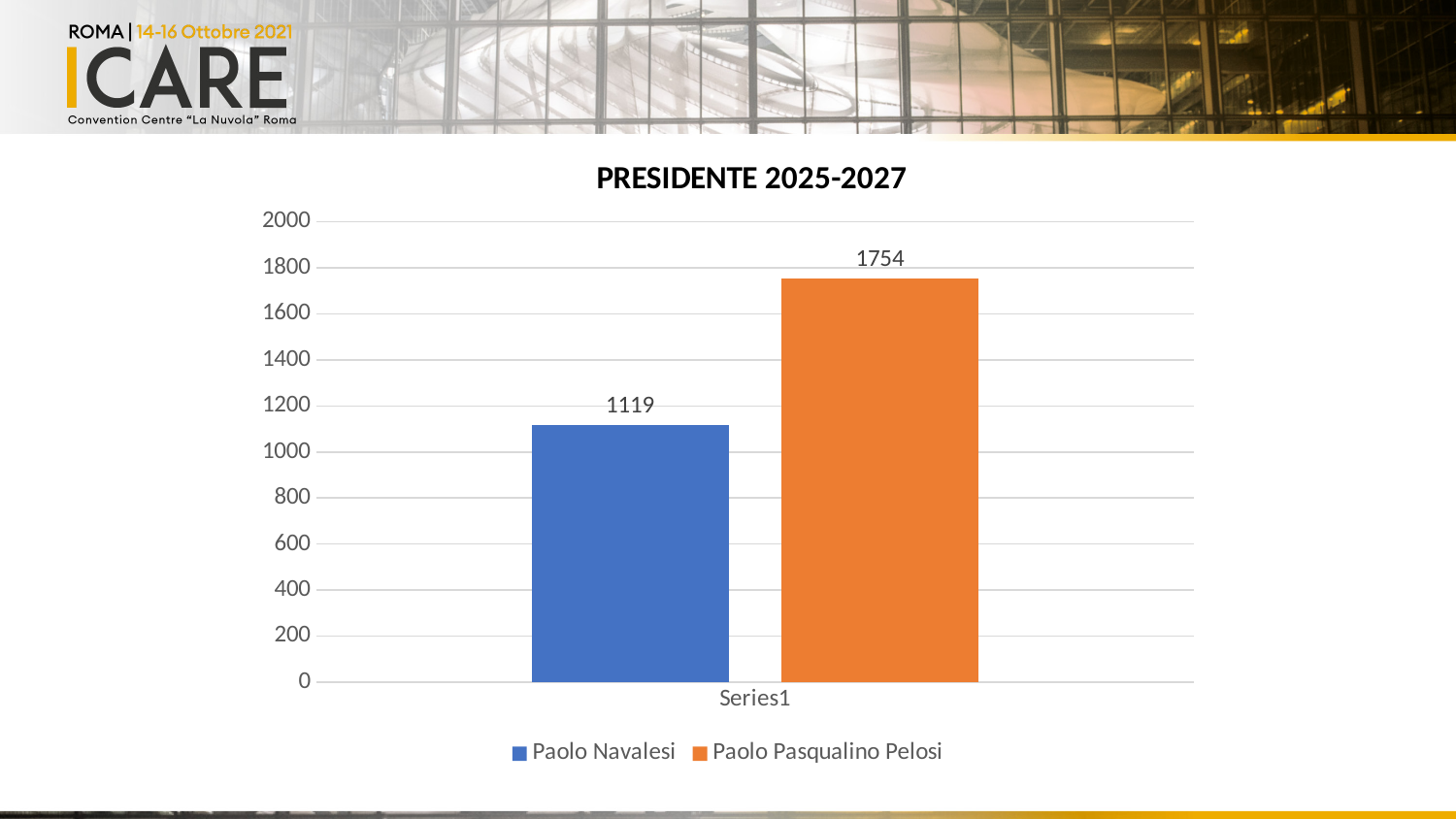
What kind of chart is shown on the slide? Bar chart Which candidate has the highest value? Paolo Pasqualino Pelosi Is the value for Paolo Navalesi greater or less than 1200? less Which candidate has the lowest value? Paolo Navalesi What is the value for Paolo Navalesi? 1119 What is the difference between the values for Paolo Pasqualino Pelosi and Paolo Navalesi? 635 How many series does the legend list? 2 Which is larger, the value for Paolo Navalesi or the value for Paolo Pasqualino Pelosi? Paolo Pasqualino Pelosi What is the value for Paolo Pasqualino Pelosi? 1754 What colour is the bar for Paolo Pasqualino Pelosi? Orange Is the value for Paolo Pasqualino Pelosi greater or less than 1600? greater What is the title of the chart? PRESIDENTE 2025-2027